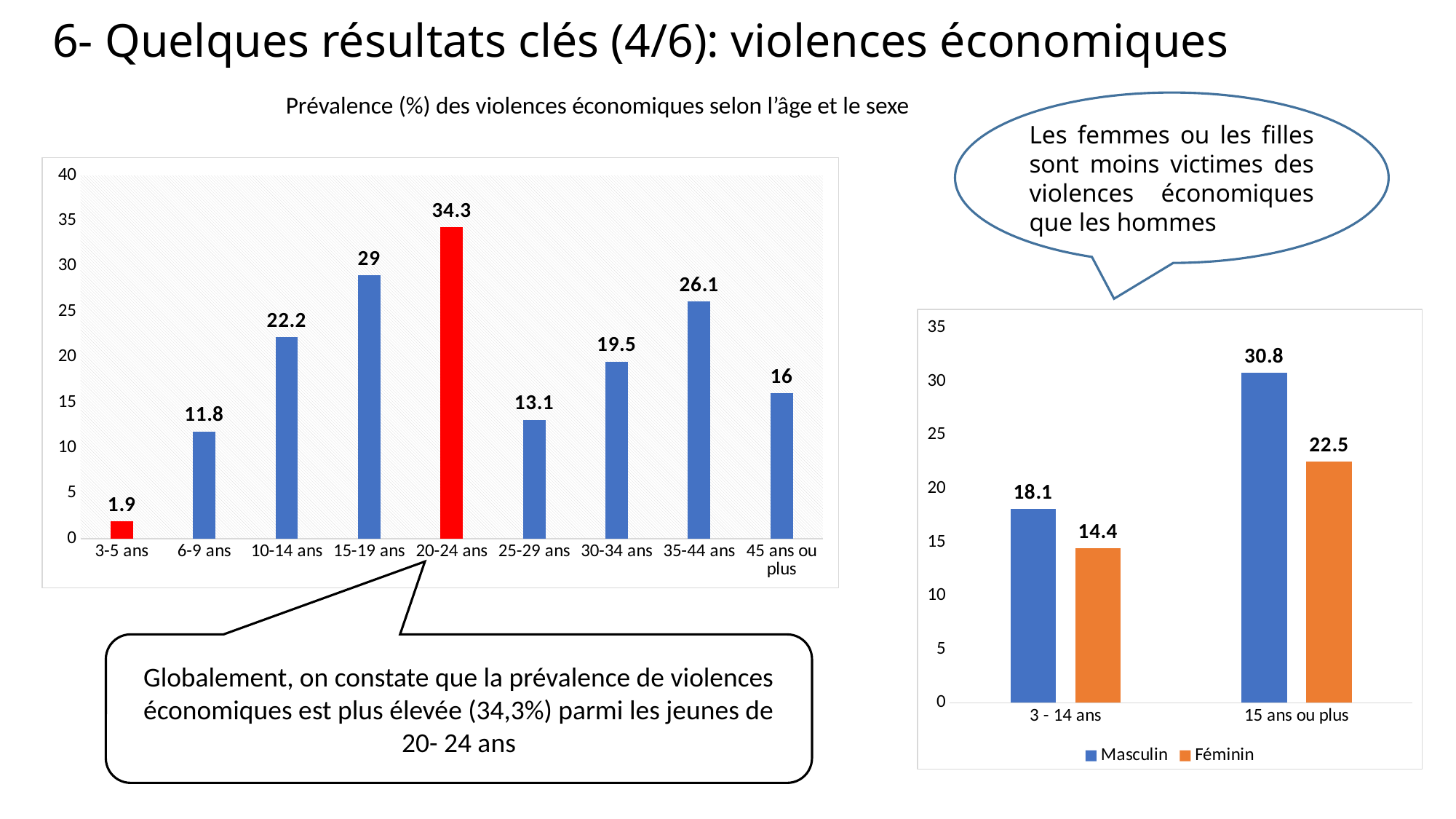
In the left chart (prevalence by age), which age group has the highest value? 20-24 ans In the left chart (prevalence by age), what is the value for 20-24 ans? 34.3 In the left chart (prevalence by age), which is larger, the value for 30-34 ans or the value for 25-29 ans? 30-34 ans In the right chart (by sex), what is the Féminin value for 15 ans ou plus? 22.5 What kind of chart is the right chart (by sex)? Bar chart In the left chart (prevalence by age), what is the difference between the values for 15-19 ans and 10-14 ans? 6.8 In the left chart (prevalence by age), which age group has the lowest value? 3-5 ans In the right chart (by sex), what is the difference between the Masculin and Féminin values for 3 - 14 ans? 3.7 In the right chart (by sex), how many series does the legend list? 2 In the left chart (prevalence by age), what colour are the bars for 3-5 ans and 20-24 ans? Red In the left chart (prevalence by age), how many age groups are shown on the x axis? 9 In the left chart (prevalence by age), what is the value for 35-44 ans? 26.1